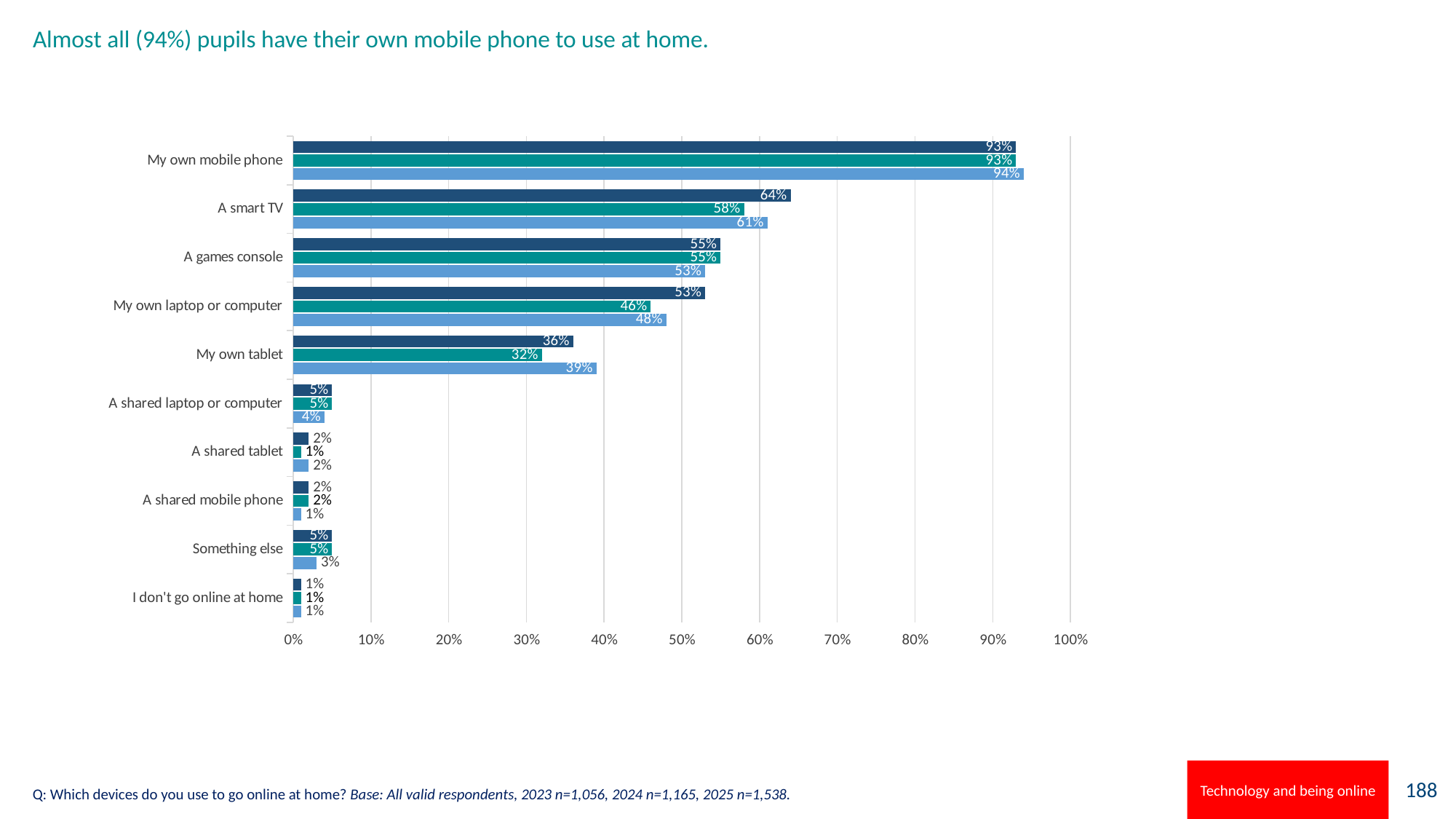
Which device category has the highest values on the chart? My own mobile phone What kind of chart is shown on the slide? bar chart What is the value of the light blue (bottom) bar for 'My own mobile phone'? 94% How many bars are shown for each device category? 3 What is the title of the slide? Almost all (94%) pupils have their own mobile phone to use at home. How many device categories are listed on the chart? 10 What is the difference between the dark blue (top) bar and the teal (middle) bar for 'A smart TV'? 6% For 'My own tablet', which is larger: the dark blue (top) bar or the teal (middle) bar? the dark blue (top) bar What is the value of the teal (middle) bar for 'My own laptop or computer'? 46% Which device category has the lowest values on the chart? I don't go online at home What is the value of the light blue (bottom) bar for 'My own tablet'? 39% What is the value of the dark blue (top) bar for 'A smart TV'? 64%